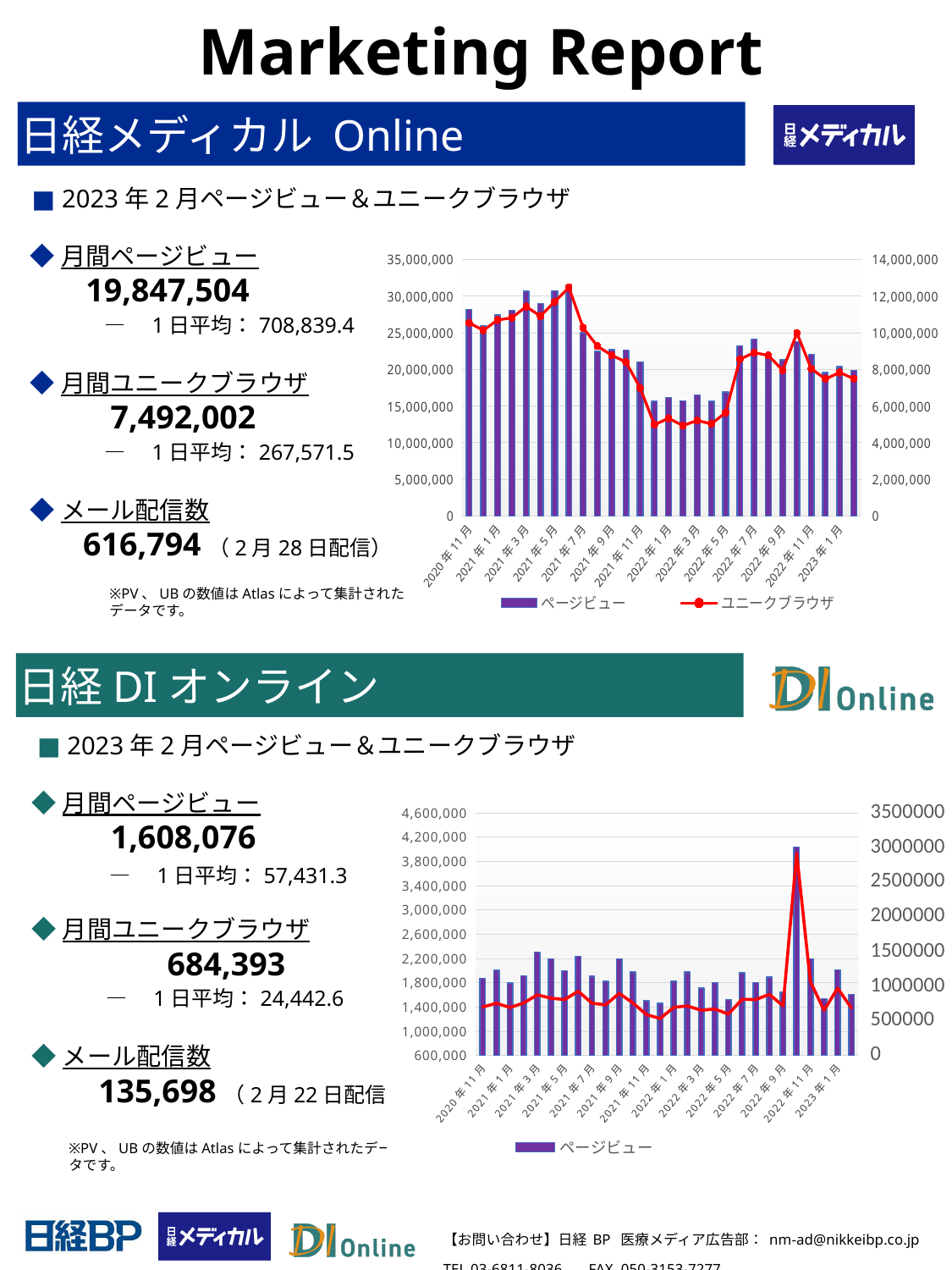
How many month labels are shown on the x axis of the 日経メディカル Online chart? 14 In the 日経メディカル Online chart, do the ページビュー bars rise or fall between 2021年7月 and 2022年1月? fall What kind of chart is shown in the 日経メディカル Online section? A combined bar and line chart In the 日経メディカル Online chart, which series is drawn as a red line? ユニークブラウザ In the 日経メディカル Online chart, is the ページビュー bar for 2020年11月 greater or less than 25,000,000? greater How many series does the legend of the 日経メディカル Online chart list? 2 In the 日経DIオンライン chart, is the ページビュー bar for 2021年11月 greater or less than 2,600,000? less In the 日経メディカル Online chart, is the ページビュー bar for 2022年1月 greater or less than 20,000,000? less What is the highest value shown on the left axis of the 日経DIオンライン chart? 4,600,000 How many series does the legend of the 日経DIオンライン chart list? 1 In the 日経メディカル Online chart, which has the larger ページビュー bar: 2020年11月 or 2022年1月? 2020年11月